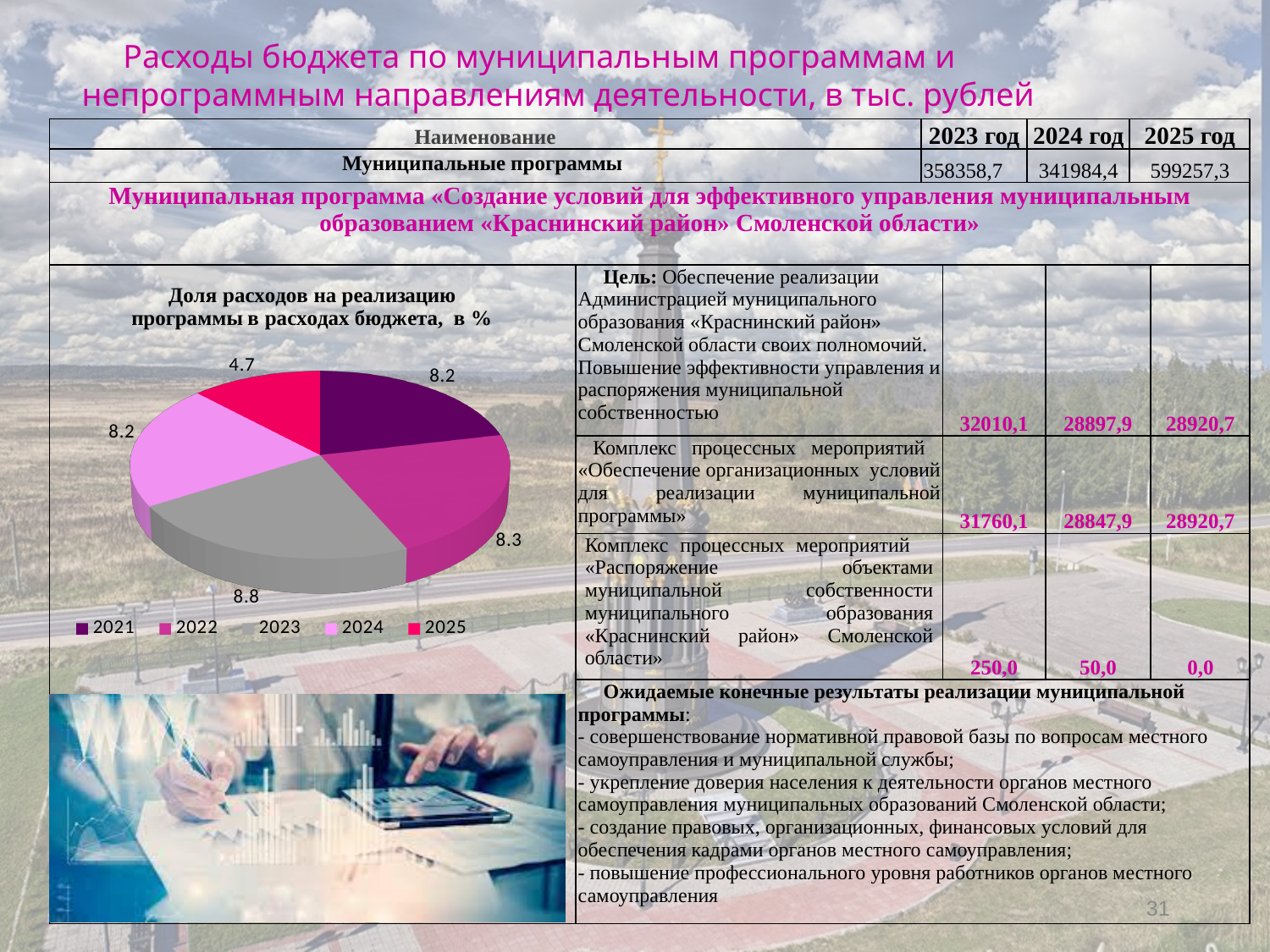
Which is larger in the pie chart, the value for 2022 or the value for 2025? 2022 How many slices does the pie chart have? 5 What is the title of the chart on the slide? Доля расходов на реализацию программы в расходах бюджета, в % What is the value for 2021 in the pie chart? 8.2 How many entries does the chart legend list? 5 Which year has the largest slice in the pie chart? 2023 Which year has the smallest slice in the pie chart? 2025 What is the value for 2022 in the pie chart? 8.3 What is the difference between the values for 2023 and 2025 in the pie chart? 4.1 What is the value for 2025 in the pie chart? 4.7 What type of chart is shown on the slide? pie chart What is the value for 2023 in the pie chart? 8.8